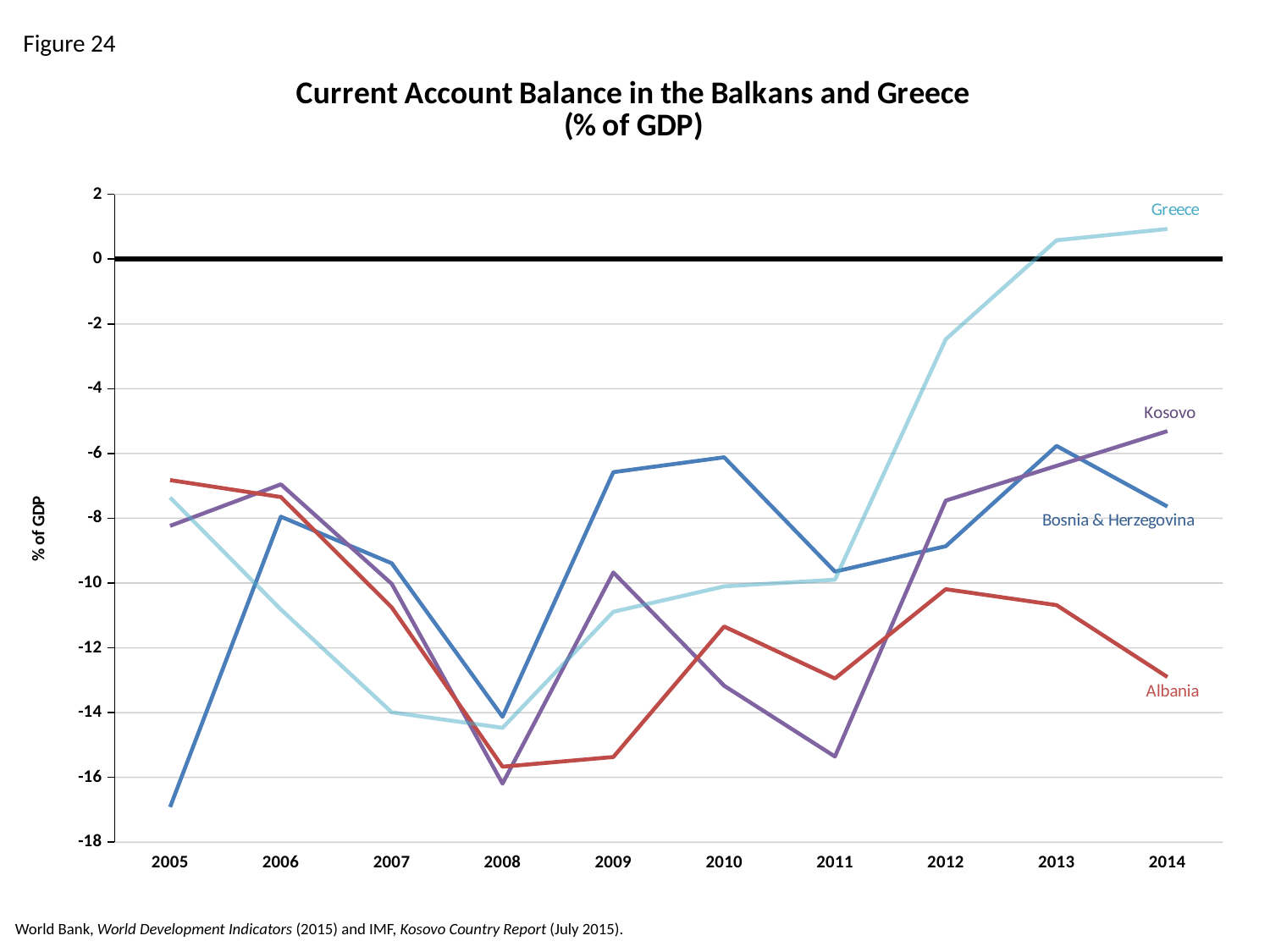
Is the value for Greece in 2014 greater or less than 0? greater Which country has the lowest current account balance in 2005? Bosnia & Herzegovina How many countries (series) are plotted on the chart? 4 Which country has the highest current account balance in 2014? Greece How many years are plotted along the x axis? 10 Is the value for Albania in 2014 greater or less than -12? less Does the value for Greece rise or fall from 2011 to 2014? rise What kind of chart is shown on the slide? line chart Is the value for Bosnia & Herzegovina in 2005 greater or less than -16? less What is the label on the y axis? % of GDP In 2011, which is higher: the value for Greece or the value for Kosovo? Greece